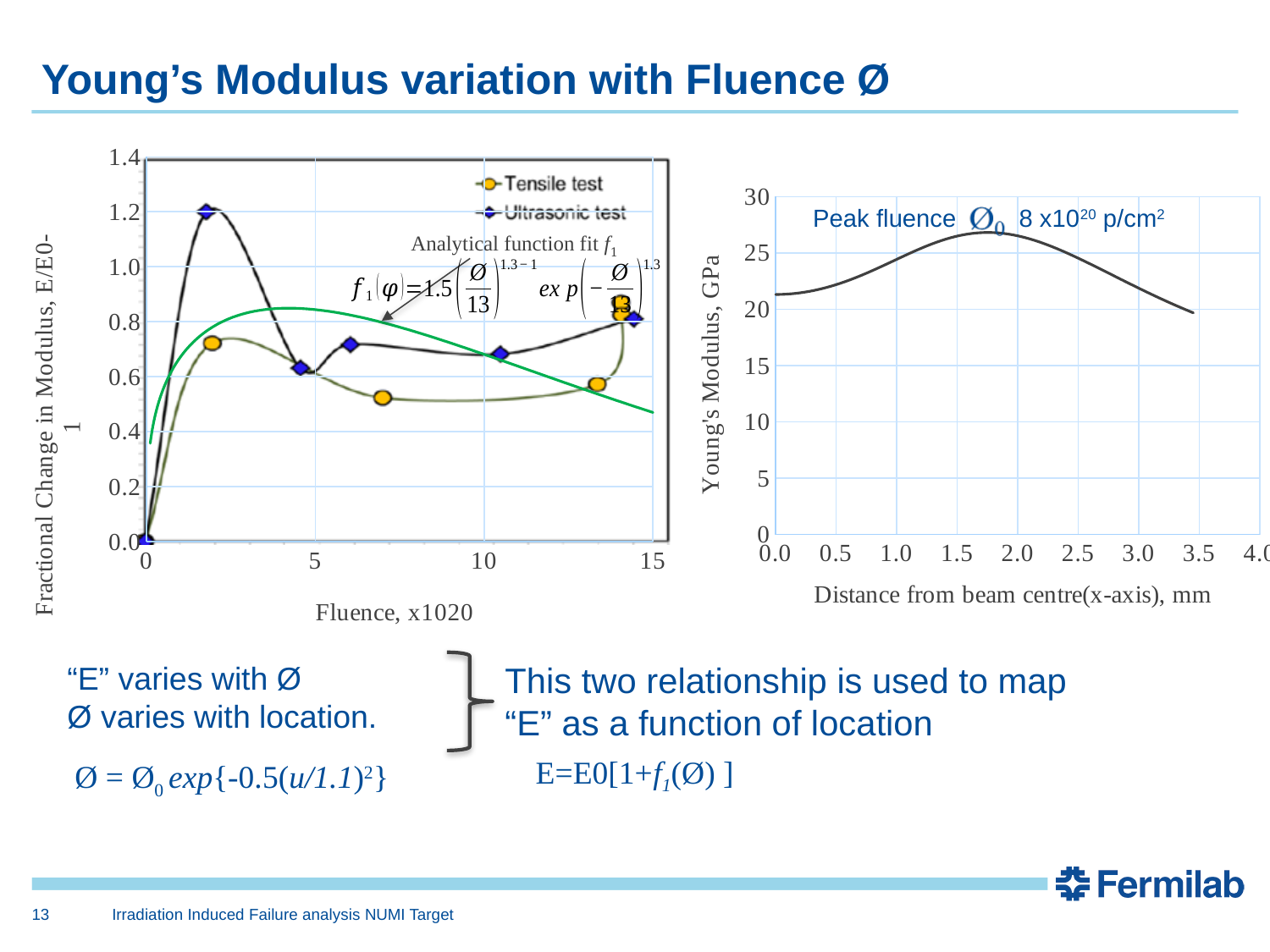
On the right chart, what peak fluence value is annotated? 8 x10^20 p/cm² On the left chart, does the Ultrasonic test series rise or fall between a fluence of about 2 and about 5? fall On the left chart, what are the two series named in the legend? Tensile test and Ultrasonic test On the left chart, at a fluence of about 2, which series has the larger value, Tensile test or Ultrasonic test? Ultrasonic test On the right chart, what is the label of the x axis? Distance from beam centre(x-axis), mm On the right chart, how does Young's Modulus change as distance from the beam centre increases from 0 to 3.5 mm? It rises to a peak near 1.8 mm, then falls On the left chart, how many series does the legend list? 2 On the right chart, is the Young's Modulus at a distance of 3.0 mm greater or less than 25 GPa? less On the left chart, is the highest Ultrasonic test value greater or less than 1.0? greater What kind of chart is the right chart (Young's Modulus vs distance from beam centre)? line chart On the left chart, is the Tensile test value at a fluence of about 7 greater or less than 0.6? less